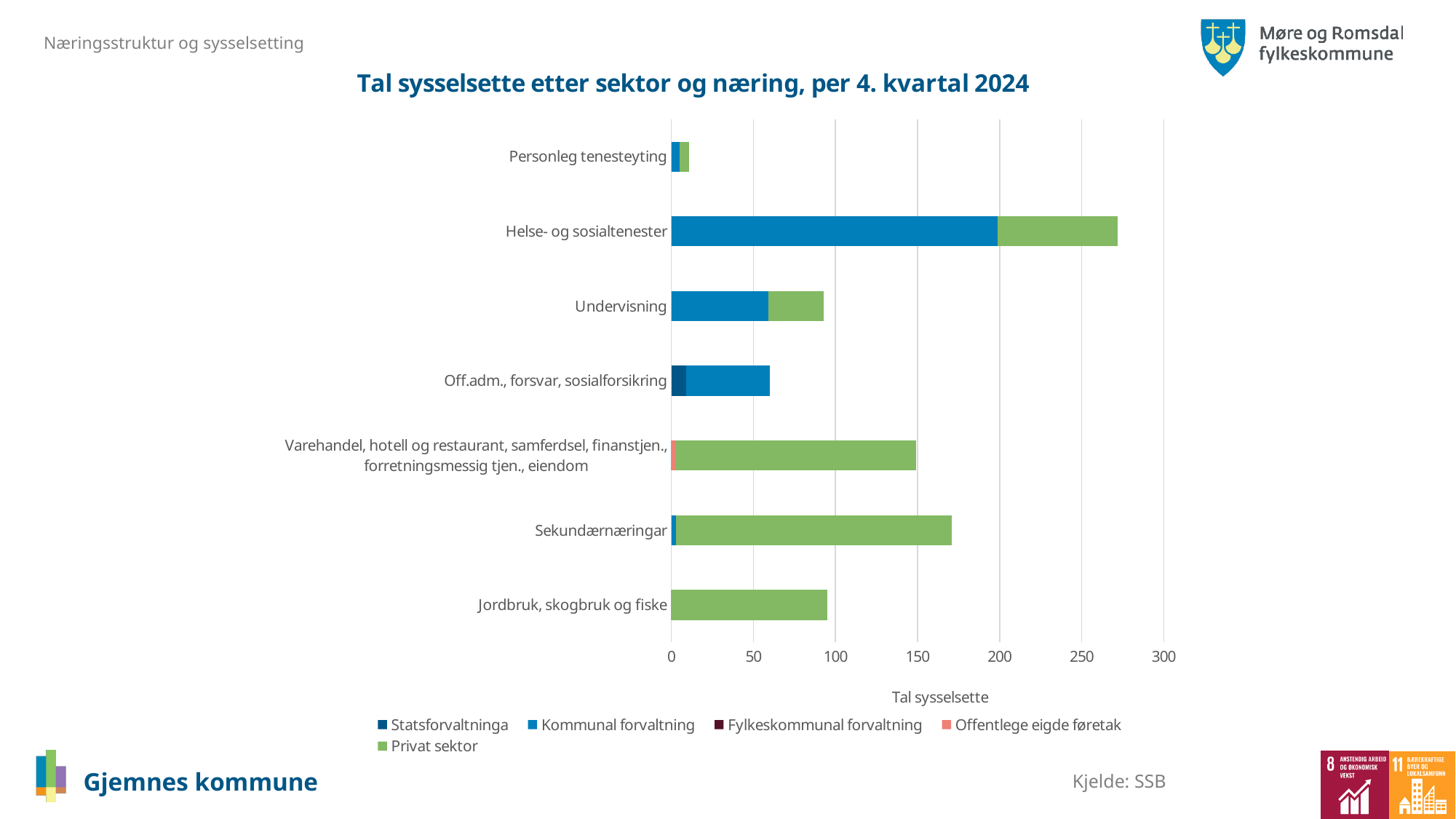
How many categories (industries) are shown on the y axis of the chart? 7 Is the total value for Sekundærnæringar greater or less than 150? greater Which series is shown in green in the legend? Privat sektor Which category has the longest total bar? Helse- og sosialtenester What kind of chart is shown on the slide? Stacked bar chart Is the total value for Helse- og sosialtenester greater or less than 250? greater Is the total value for Off.adm., forsvar, sosialforsikring greater or less than 50? greater How many series does the legend list? 5 Which has the larger total bar: Sekundærnæringar or Varehandel, hotell og restaurant, samferdsel, finanstjen., forretningsmessig tjen., eiendom? Sekundærnæringar What is the title of the chart? Tal sysselsette etter sektor og næring, per 4. kvartal 2024 Which category has the shortest total bar? Personleg tenesteyting